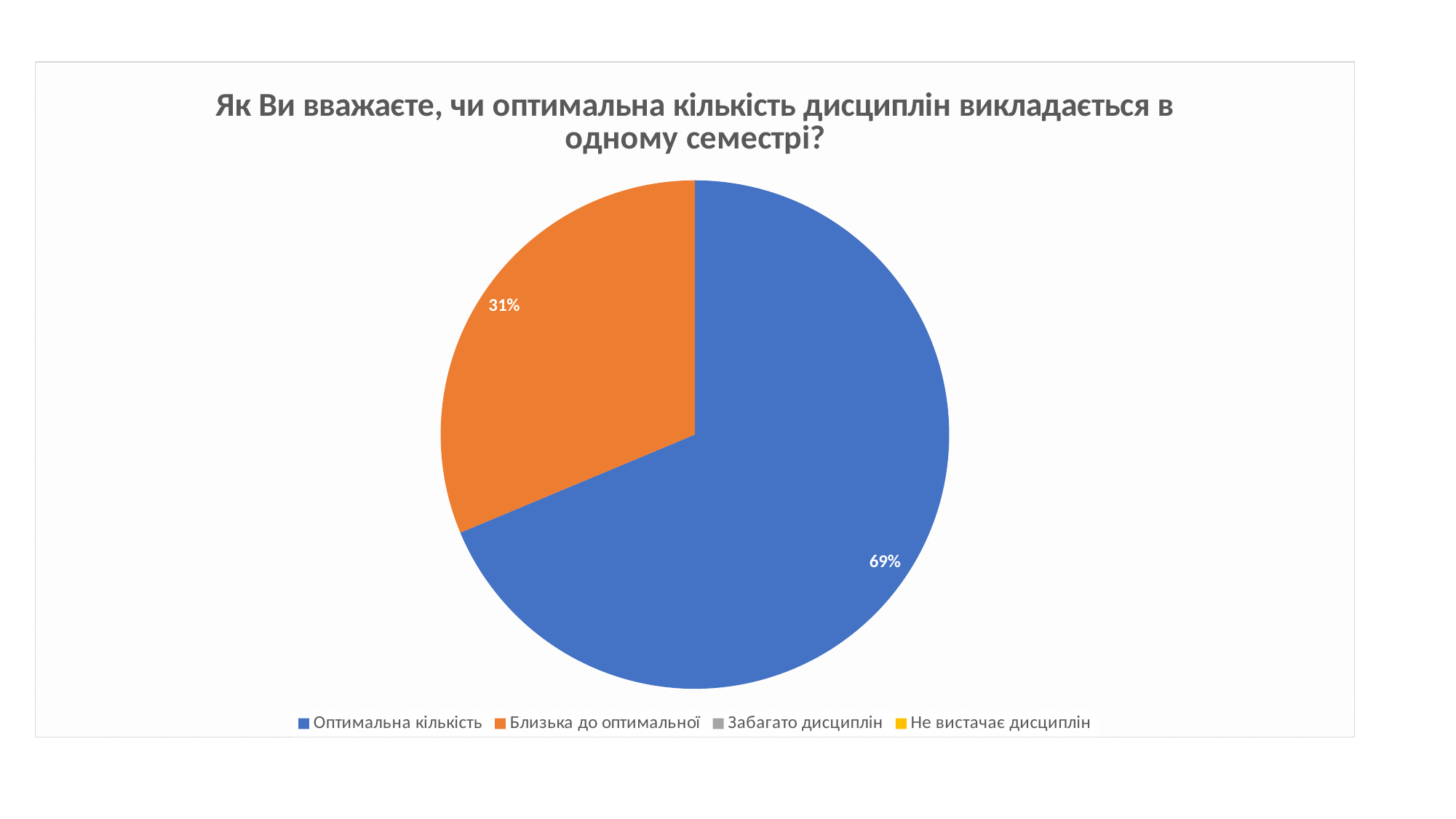
What kind of chart is shown on the slide? Pie chart How many categories does the legend list? 4 What is the difference in percentage points between the "Оптимальна кількість" and "Близька до оптимальної" slices? 38% What share of the pie does the "Близька до оптимальної" slice take? 31% Which of the two visible slices is smaller, "Оптимальна кількість" or "Близька до оптимальної"? Близька до оптимальної Which is larger, the "Близька до оптимальної" slice or the "Оптимальна кількість" slice? Оптимальна кількість How many slices with data labels are visible in the pie? 2 What colour is the "Оптимальна кількість" slice? Blue Which category has the largest slice of the pie? Оптимальна кількість Is the share for "Близька до оптимальної" greater or less than 50%? less What is the title of the chart? Як Ви вважаєте, чи оптимальна кількість дисциплін викладається в одному семестрі? What share of the pie does the "Оптимальна кількість" slice take? 69%